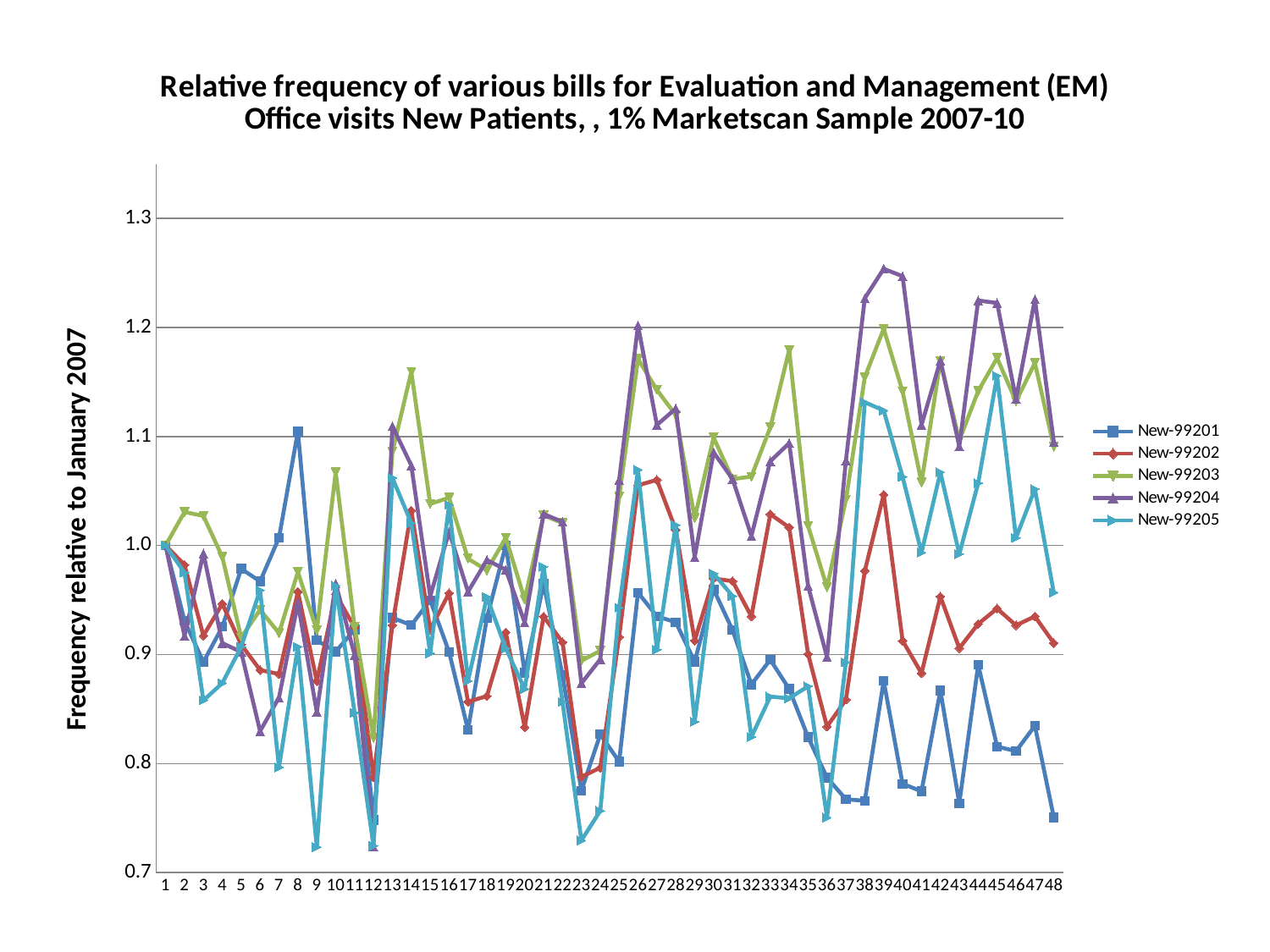
Which series has the highest value at point 39? New-99204 Which series has the lowest value at point 48? New-99201 Is the value for New-99205 at point 9 greater or less than 0.8? less At point 48, which is larger: New-99204 or New-99201? New-99204 How many series does the legend list? 5 What kind of chart is shown on the slide? line chart Is the value for New-99204 at point 39 greater or less than 1.2? greater Is the value for New-99203 at point 14 greater or less than 1.1? greater What is the value of New-99201 at point 1 on the x axis? 1.0 How many points are plotted along the x axis for each series? 48 What is the title of the y axis? Frequency relative to January 2007